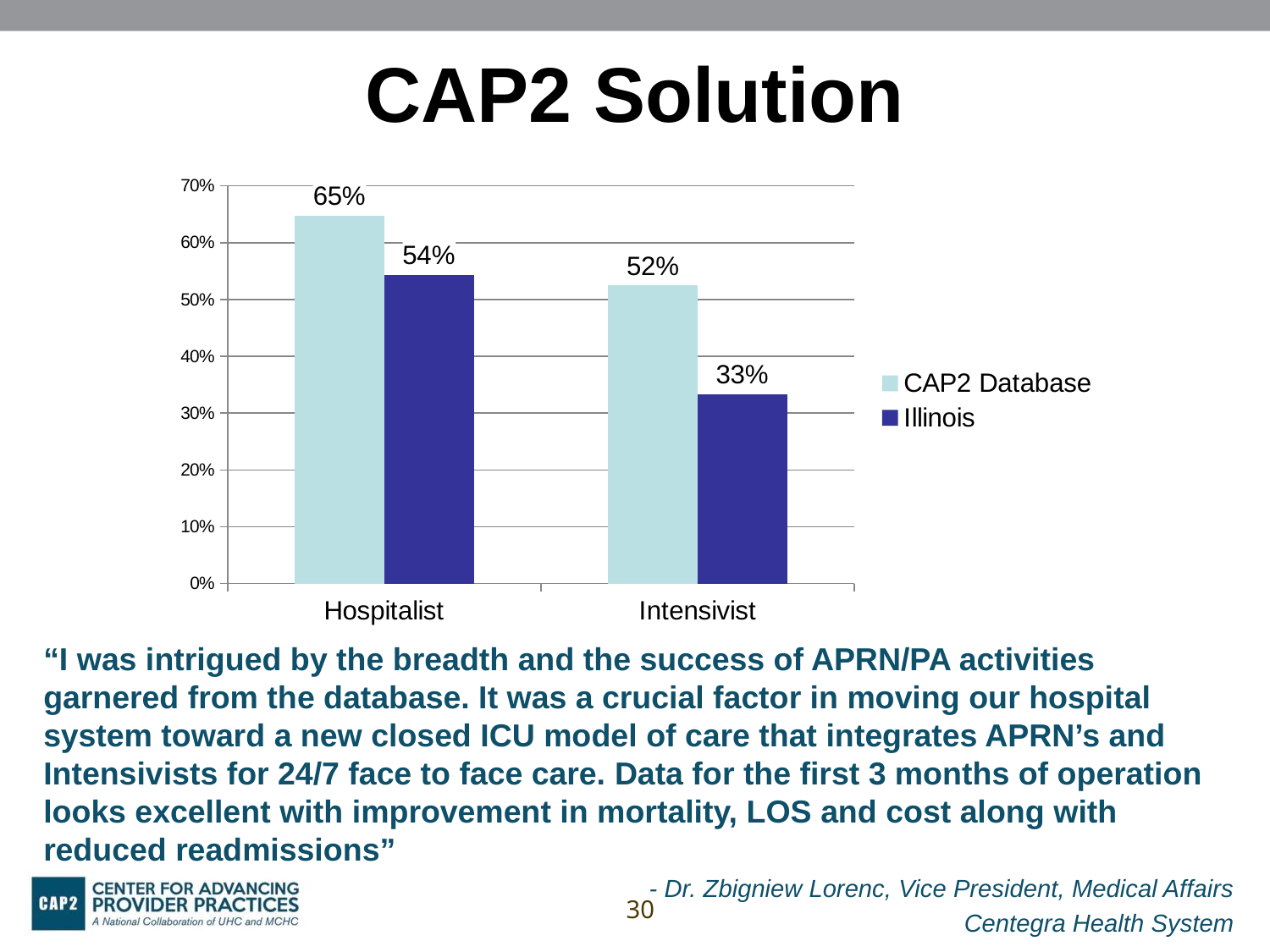
How many categories are shown on the x axis? 2 Which category has the highest CAP2 Database value? Hospitalist What is the Illinois value for Hospitalist? 54% How many series does the legend list? 2 What is the difference between the CAP2 Database and Illinois values for Hospitalist? 11% What is the Illinois value for Intensivist? 33% What is the CAP2 Database value for Hospitalist? 65% Which category has the lowest Illinois value? Intensivist What kind of chart is shown on the slide? Bar chart Which is larger for Hospitalist: the CAP2 Database value or the Illinois value? CAP2 Database What is the difference between the CAP2 Database and Illinois values for Intensivist? 19% What is the CAP2 Database value for Intensivist? 52%